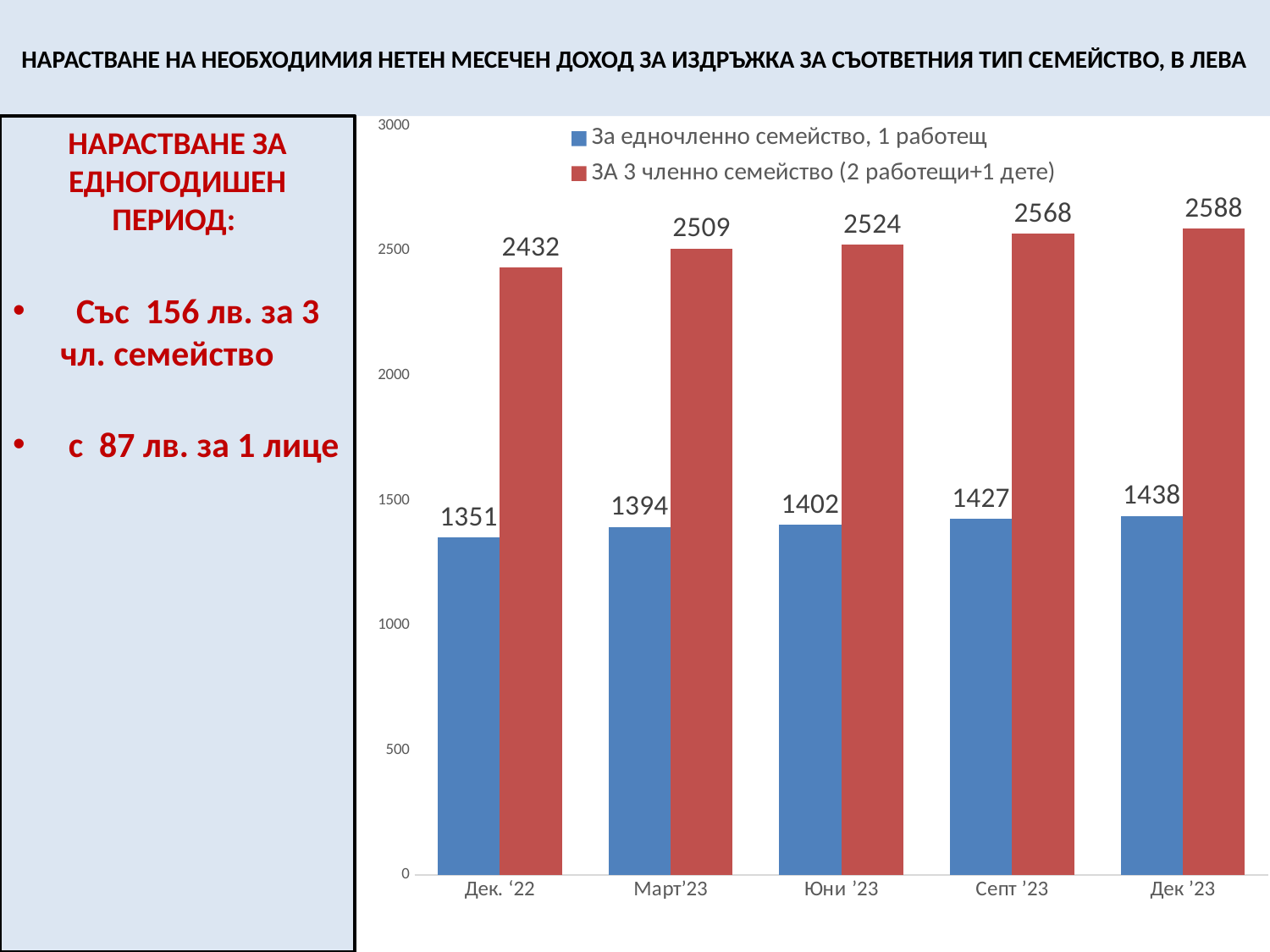
What is the value for the single-member family in Юни '23? 1402 In which period is the value for the 3-member family highest? Дек '23 How many periods are shown on the x axis? 5 Do the values for the single-member family rise or fall from Дек. '22 to Дек '23? rise What is the difference between the single-member family value in Дек '23 and in Дек. '22? 87 Which is larger in Март'23: the value for the single-member family or the 3-member family? 3-member family (ЗА 3 членно семейство) What is the difference between the 3-member family value in Дек '23 and in Дек. '22? 156 How many series does the legend list? 2 In which period is the value for the single-member family lowest? Дек. '22 What is the value for the single-member family (За едночленно семейство, 1 работещ) in Дек. '22? 1351 Is the value for the 3-member family in Септ '23 greater or less than 2500? greater What is the value for the 3-member family (ЗА 3 членно семейство) in Дек '23? 2588